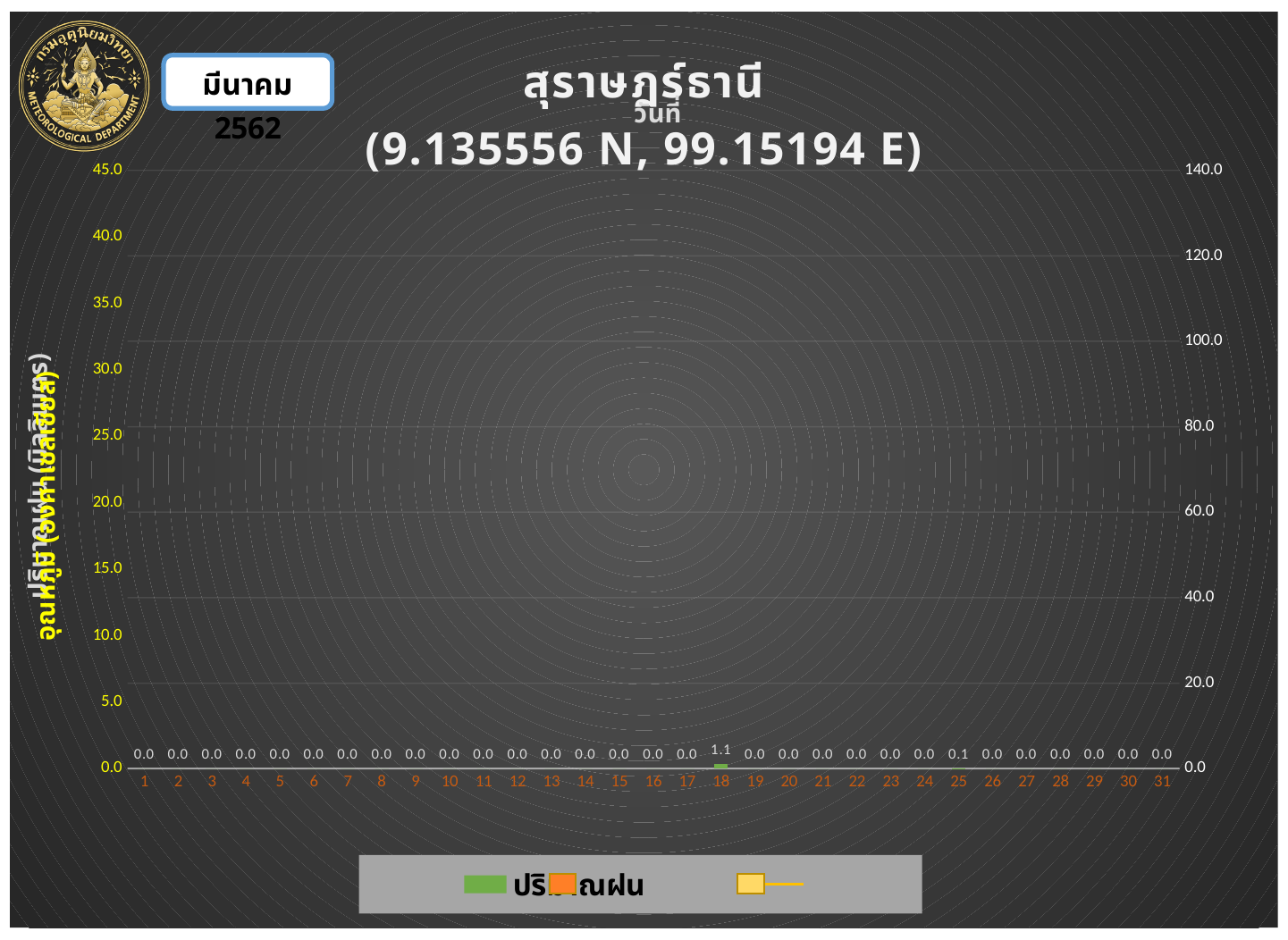
Which day has the larger rainfall value, day 18 or day 25? 18 What is the rainfall value shown for day 18? 1.1 What is the rainfall value shown for day 25? 0.1 Which day has the highest rainfall value? 18 Is the rainfall value for day 18 greater or less than 5.0? less What is the highest tick value on the right vertical axis? 140.0 What is the highest tick value on the left vertical axis? 45.0 What is the difference between the rainfall values for day 18 and day 25? 1.0 What is the rainfall value shown for day 1? 0.0 How many days are shown on the x axis? 31 What kind of chart is shown on the slide? bar chart